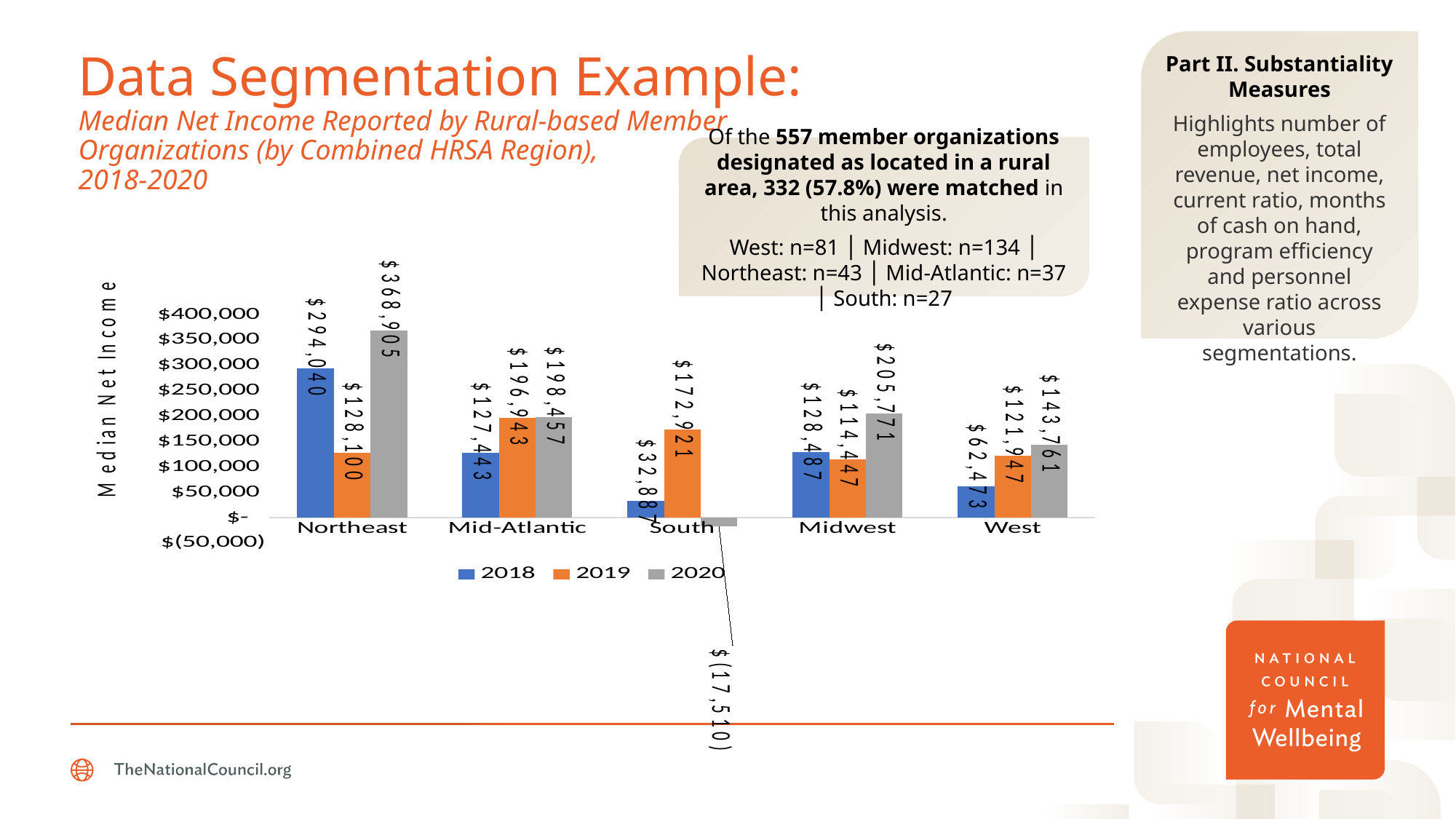
What is the 2018 median net income for the West region? $62,473 What type of chart is shown on the slide? Bar chart Which region has the lowest 2018 median net income? South What is the 2019 median net income for the South region? $172,921 What is the 2020 median net income for the Northeast region? $368,905 Which is larger for the Midwest region: the 2018 or the 2019 median net income? 2018 How many regions are shown on the x axis? 5 Which region has the highest 2020 median net income? Northeast What is the difference between the 2020 and 2018 median net income for the Northeast region? $74,865 How many series does the legend list? 3 What is the 2020 median net income for the South region? $(17,510) What is the label of the y axis? Median Net Income